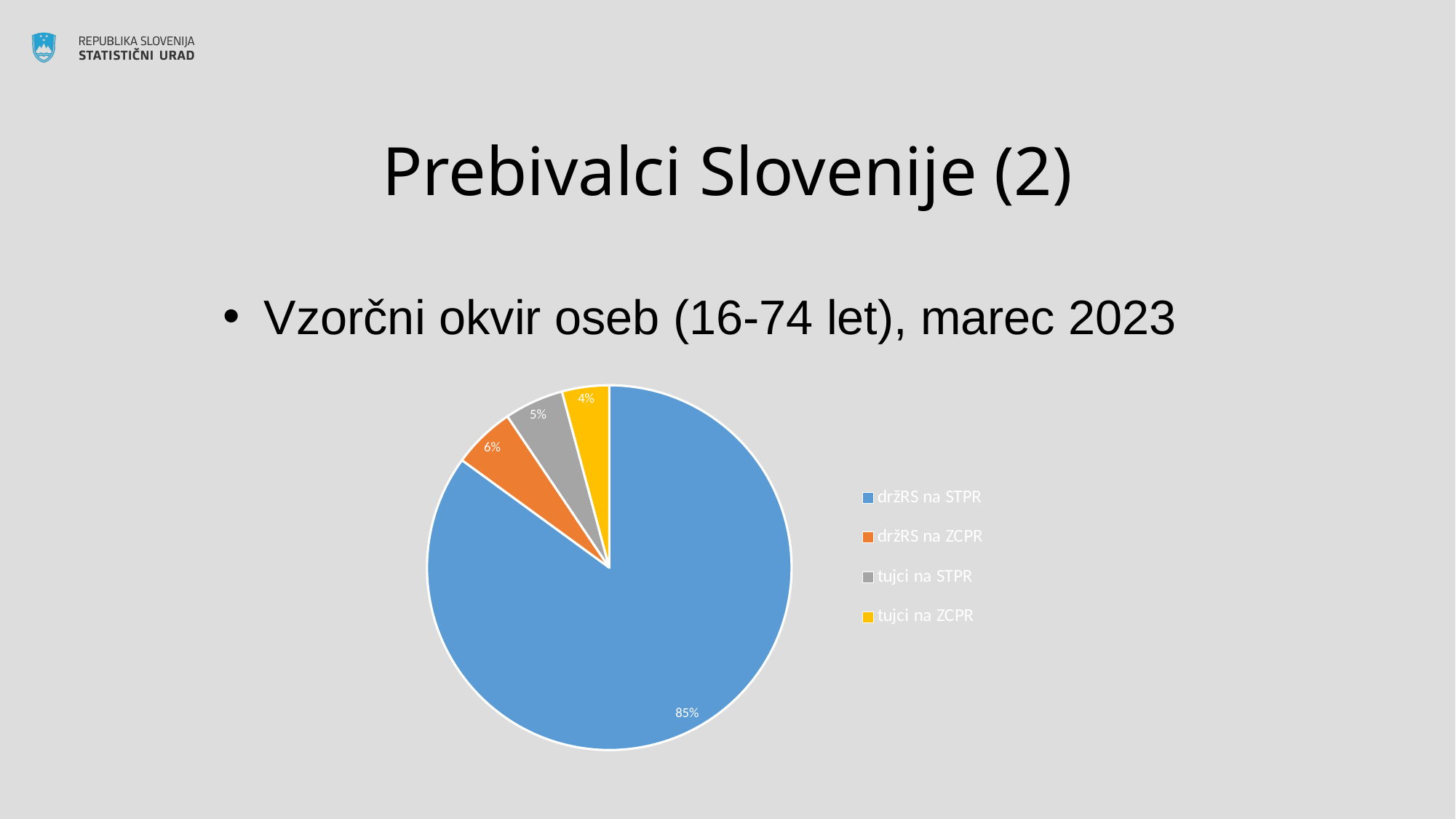
How many entries does the legend list? 4 What is the difference in percentage points between "držRS na STPR" and "držRS na ZCPR"? 79 How many slices does the pie chart have? 4 Which category has the largest slice of the pie? držRS na STPR What share of the pie does "držRS na STPR" have? 85% What kind of chart is shown on the slide? pie chart Which is larger, the slice for "držRS na ZCPR" or the slice for "tujci na ZCPR"? držRS na ZCPR What share of the pie does "tujci na ZCPR" have? 4% What colour is the slice for "tujci na STPR"? grey Which category has the smallest slice of the pie? tujci na ZCPR What share of the pie does "tujci na STPR" have? 5%